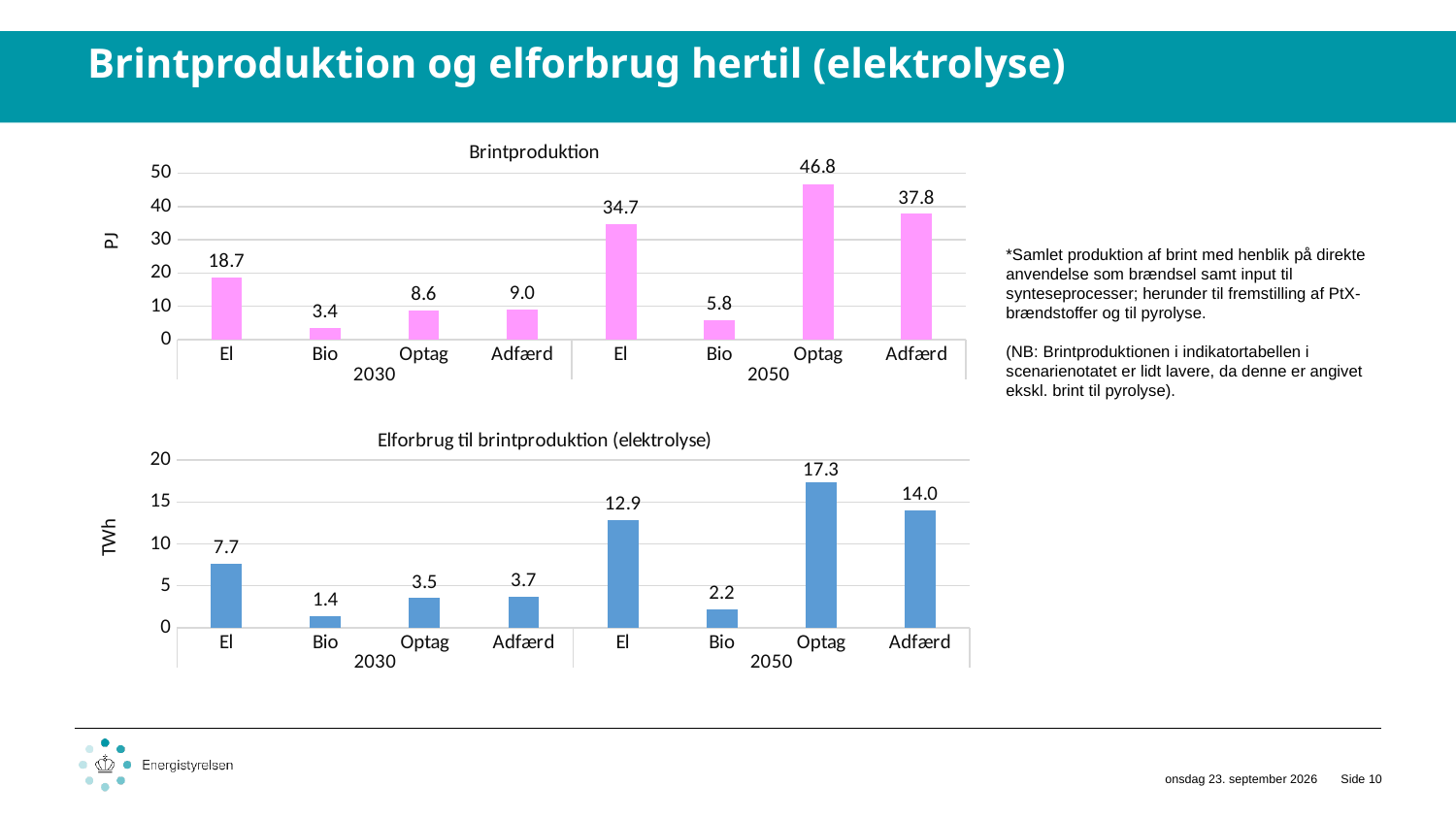
In the Elforbrug til brintproduktion (elektrolyse) chart, is the value for Bio in 2030 greater or less than 5? less What unit is shown on the y axis of the Brintproduktion chart? PJ In the Brintproduktion chart, which category has the lowest value? Bio (2030) In the Elforbrug til brintproduktion (elektrolyse) chart, what is the value for El in 2050? 12.9 In the Elforbrug til brintproduktion (elektrolyse) chart, which category has the highest value? Optag (2050) In the Brintproduktion chart, which is larger: El in 2050 or Adfærd in 2050? Adfærd in 2050 In the Brintproduktion chart, how many bars are plotted? 8 In the Brintproduktion chart, what is the value for Optag in 2050? 46.8 In the Elforbrug til brintproduktion (elektrolyse) chart, what is the difference between Optag in 2050 and Optag in 2030? 13.8 What type of chart is the Elforbrug til brintproduktion (elektrolyse) chart? Bar chart In the Brintproduktion chart, what is the value for El in 2030? 18.7 In the Brintproduktion chart, what is the difference between Adfærd in 2050 and Adfærd in 2030? 28.8